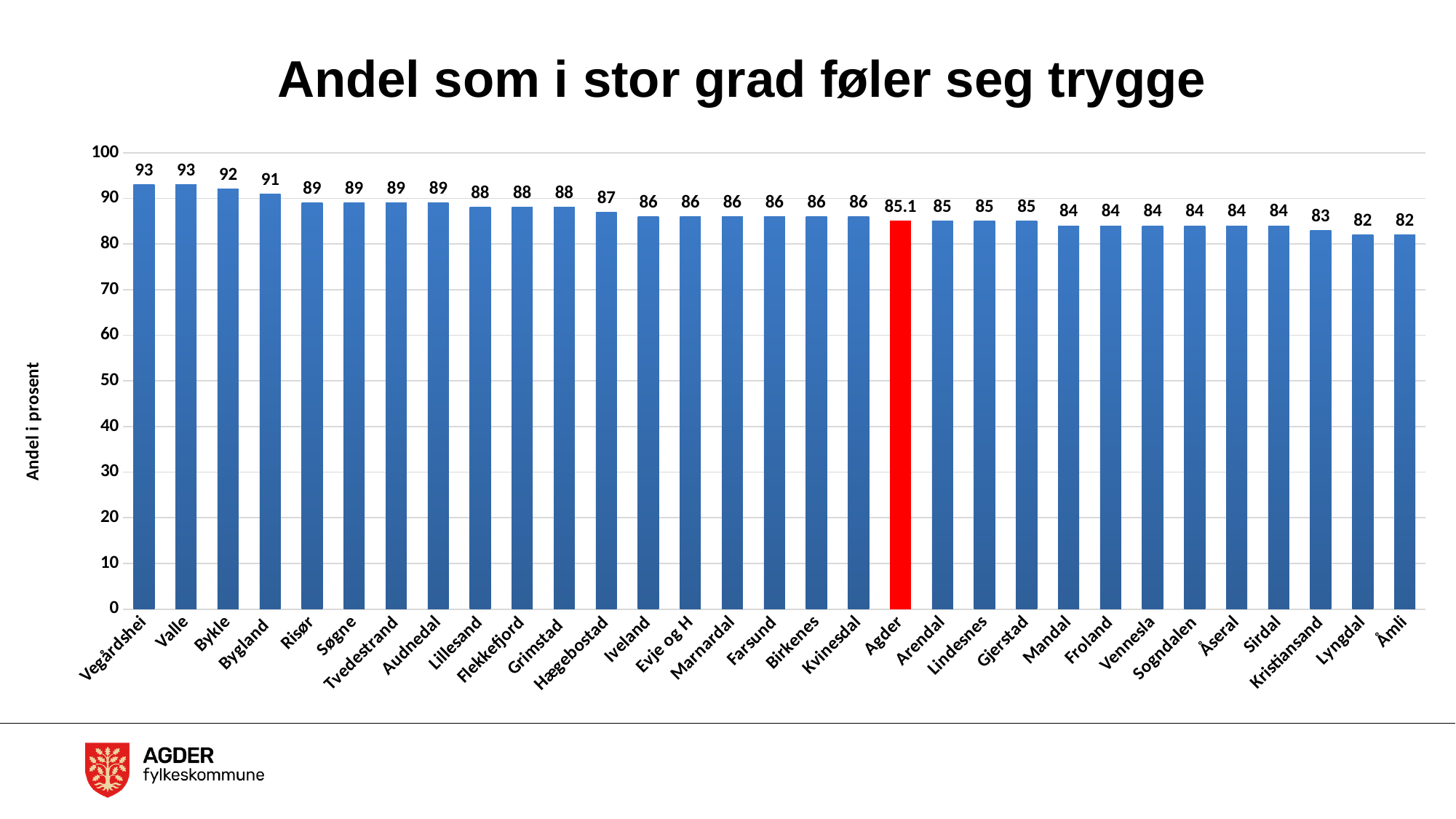
What kind of chart is shown on the slide? bar chart What is the difference between the values for Bykle and Kristiansand? 9 Which has a larger value, Bygland or Mandal? Bygland Which category is shown with a red bar? Agder Is the value for Risør greater or less than 80? greater How many categories are shown on the x axis? 31 What is the value for Grimstad? 88 What is the value for Kristiansand? 83 What is the difference between the values for Vegårdshei and Åmli? 11 Do the values rise or fall from left to right along the x axis? fall What is the value for Agder? 85.1 What is the value for Bykle? 92